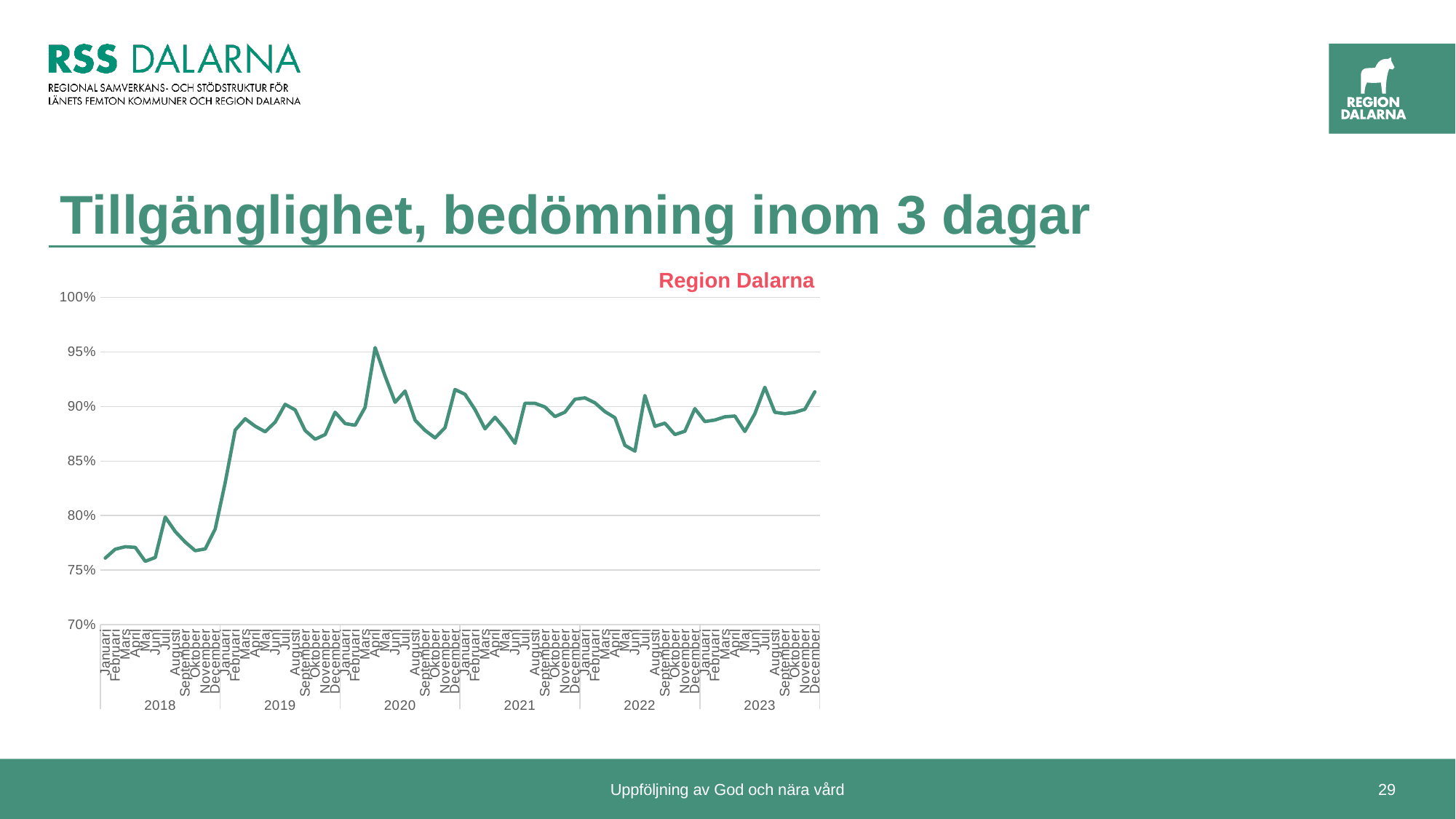
How many years are labelled along the x axis of the chart? 6 Does the line rise or fall from the start of 2018 to the start of 2019? rise Is the value for Juni 2022 greater or less than 90%? less How many lines (series) are plotted in the chart? 1 In which year does the line reach its lowest point? 2018 What kind of chart is shown on the slide? line chart Is the value for December 2023 greater or less than 90%? greater Is the value for April 2020 greater or less than 90%? greater In which year does the line reach its highest point? 2020 What is the title shown above the chart? Region Dalarna